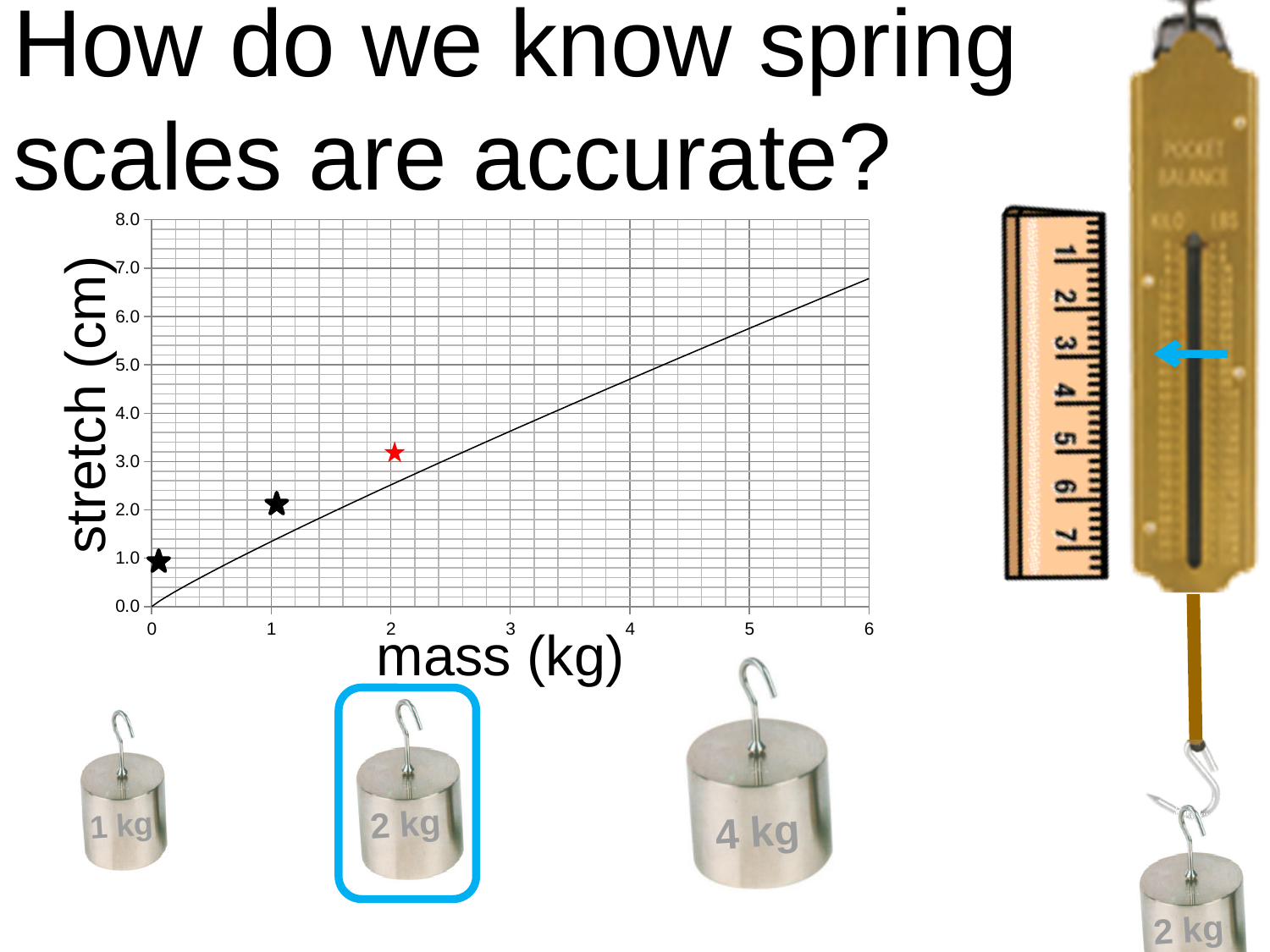
Is the stretch value of the fitted line at 6 kg greater or less than 6.0 cm? greater Which plotted point has the highest stretch value? the red star at 2 kg What kind of chart is shown on the slide? scatter chart Which plotted point has the lowest stretch value? the star at 0 kg Is the stretch value for the point at 0 kg greater or less than 2.0 cm? less How many star data points are plotted on the chart? 3 What is the label of the x axis of the chart? mass (kg) Does the stretch increase or decrease as mass increases along the x axis? increase Which has a larger stretch value, the point at 1 kg or the point at 2 kg? the point at 2 kg What is the label of the y axis of the chart? stretch (cm) Is the stretch value for the point at 2 kg greater or less than 2.0 cm? greater